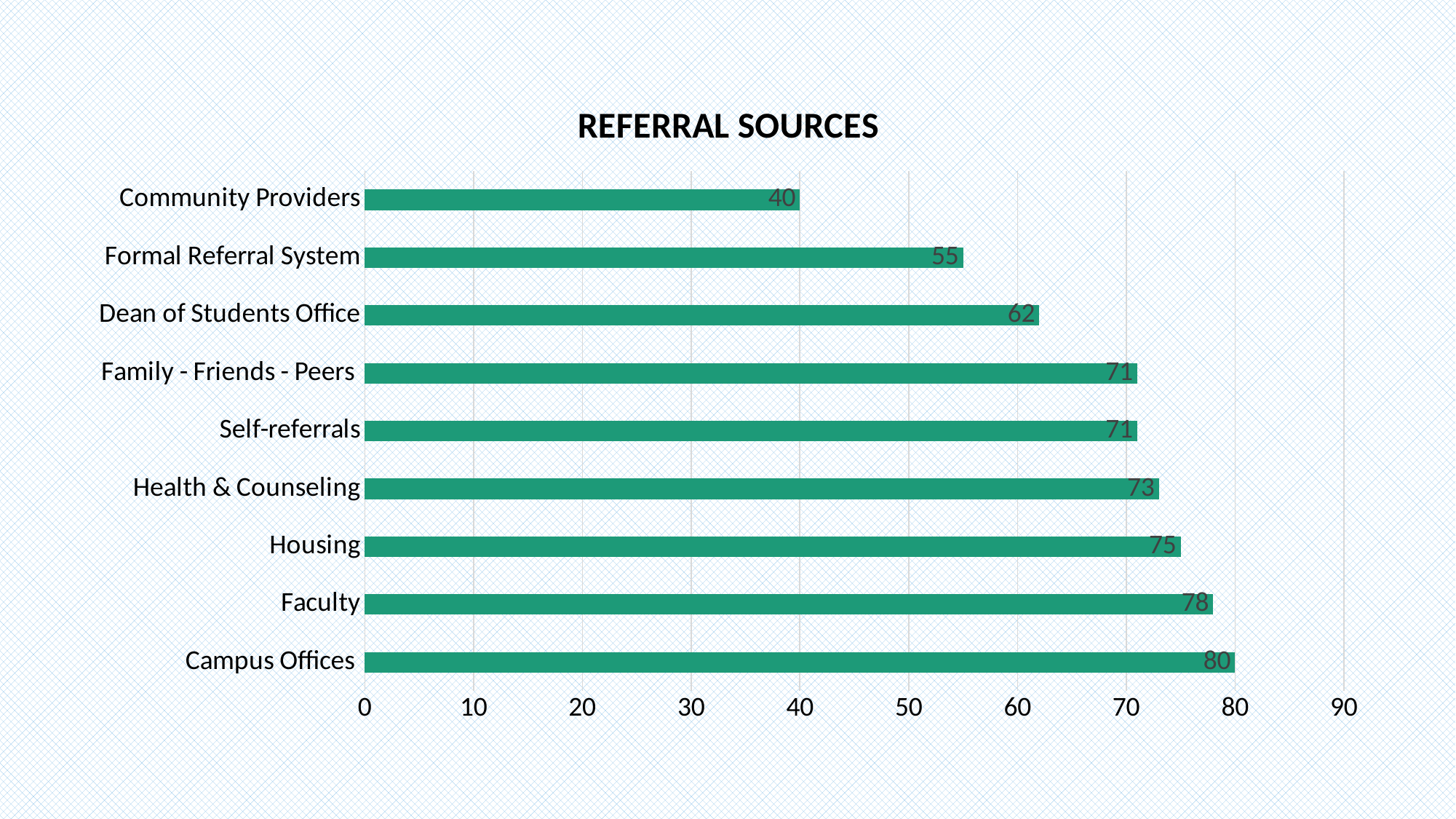
What is the title of the chart? REFERRAL SOURCES What is the value for Campus Offices? 80 Which referral source has the highest value? Campus Offices What is the value for Community Providers? 40 What kind of chart is shown on the slide? bar chart Which referral source has the lowest value? Community Providers Which is larger, the value for Housing or the value for Dean of Students Office? Housing What is the difference between the values for Faculty and Formal Referral System? 23 How many referral sources are shown in the chart? 9 What is the value for Dean of Students Office? 62 What is the value for Health & Counseling? 73 Is the value for Formal Referral System greater or less than 60? less